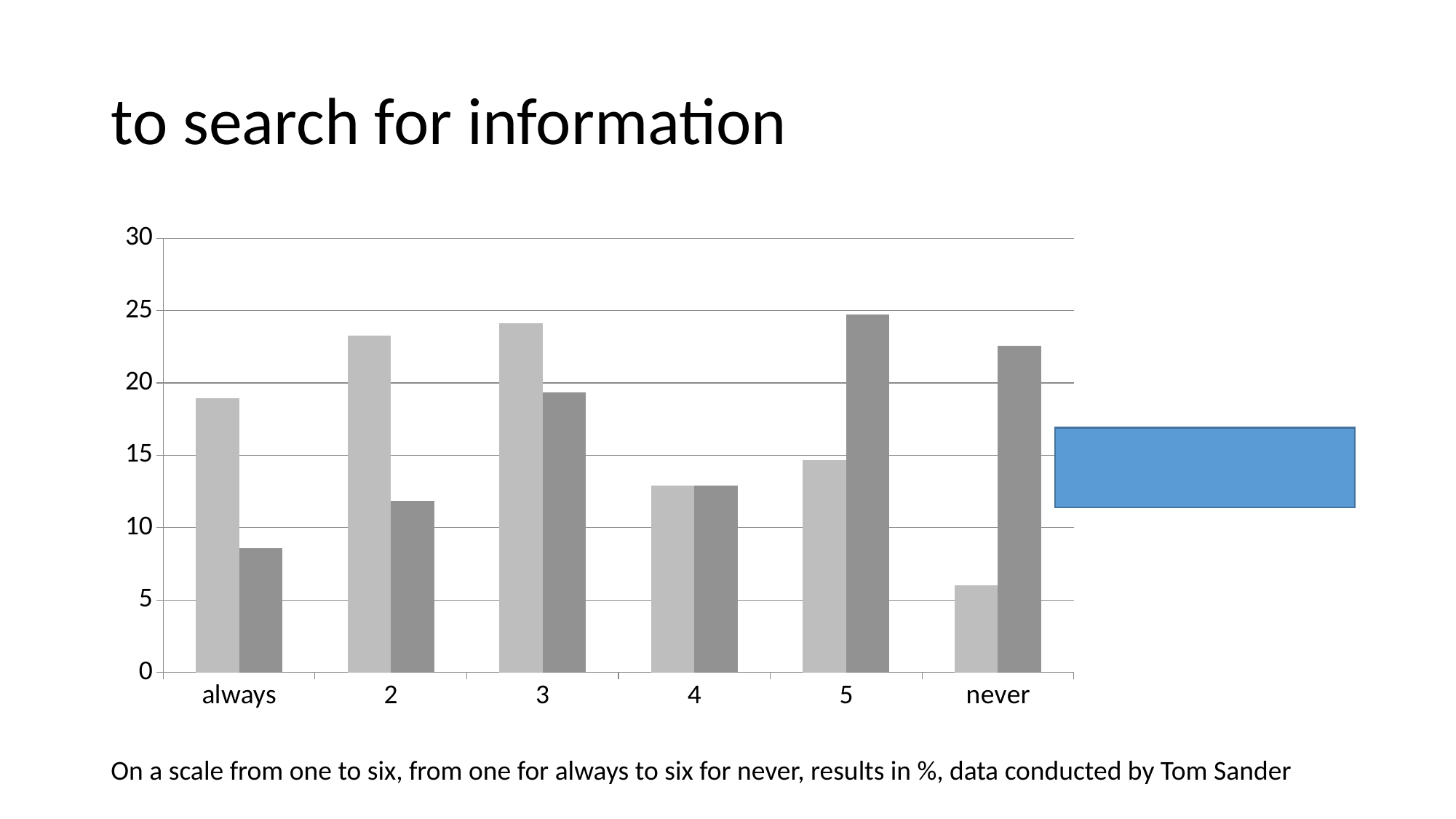
For the category 'never', which bar is taller, the light grey or the dark grey? dark grey Is the dark grey bar for 'always' greater or less than 10? less For the category '2', which bar is taller, the light grey or the dark grey? light grey What is the title of the slide containing the chart? to search for information What kind of chart is shown on the slide? bar chart How many categories are shown on the x axis? 6 Which category has the lowest dark grey bar? always Is the light grey bar for 'always' greater or less than 15? greater Is the dark grey bar for 'never' greater or less than 20? greater Which category has the lowest light grey bar? never Which category has the highest light grey bar? 3 Which category has the highest dark grey bar? 5